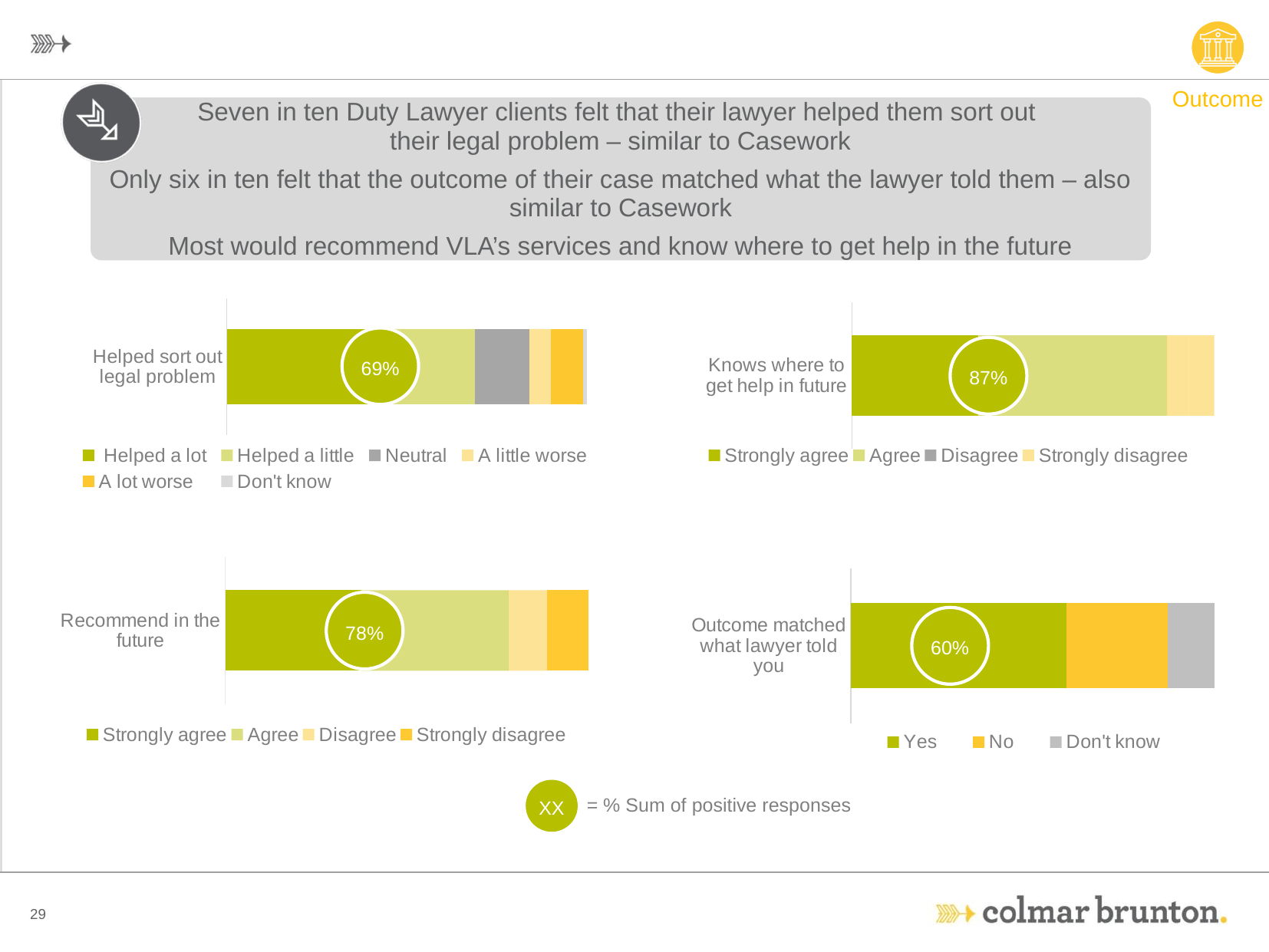
Which has a higher sum of positive responses: 'Recommend in the future' or 'Helped sort out legal problem'? Recommend in the future In the 'Outcome matched what lawyer told you' chart, what percentage is shown in the circle? 60% In the 'Outcome matched what lawyer told you' chart, which segment is larger: Yes or No? Yes In the 'Knows where to get help in future' chart, what percentage is shown in the circle? 87% What kind of chart is the 'Recommend in the future' chart? Stacked bar chart How many series does the legend of the 'Helped sort out legal problem' chart list? 6 Across the four charts on the slide, which measure has the lowest sum of positive responses? Outcome matched what lawyer told you In the 'Recommend in the future' chart, what is the sum of positive responses shown? 78% In the 'Helped sort out legal problem' chart, what is the sum of positive responses shown in the circle? 69% How many series does the legend of the 'Outcome matched what lawyer told you' chart list? 3 What is the difference in percentage points between the positive sum for 'Knows where to get help in future' and 'Outcome matched what lawyer told you'? 27 percentage points Across the four charts on the slide, which measure has the highest sum of positive responses? Knows where to get help in future